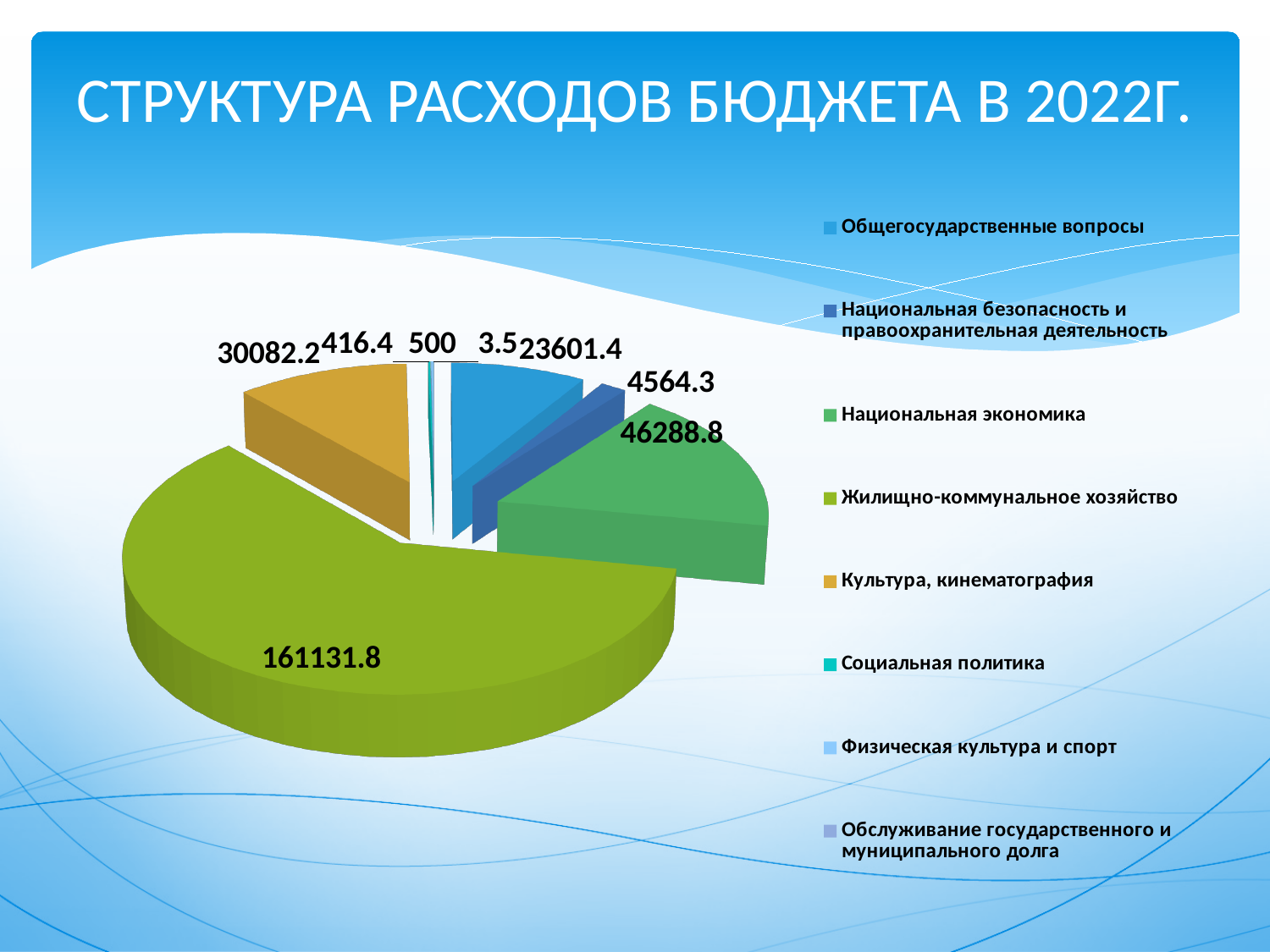
Which category has the smallest value? Обслуживание государственного и муниципального долга What is the difference between the values for Физическая культура и спорт and Социальная политика? 83.6 What is the value for Культура, кинематография? 30082.2 What is the value for Обслуживание государственного и муниципального долга? 3.5 Which is larger, the value for Культура, кинематография or the value for Общегосударственные вопросы? Культура, кинематография What is the value for Национальная экономика? 46288.8 What is the value for Жилищно-коммунальное хозяйство? 161131.8 Which category has the largest slice of the pie? Жилищно-коммунальное хозяйство What is the difference between the values for Национальная экономика and Общегосударственные вопросы? 22687.4 How many categories does the legend list? 8 What is the title of the chart on the slide? СТРУКТУРА РАСХОДОВ БЮДЖЕТА В 2022Г. What kind of chart is shown on the slide? pie chart